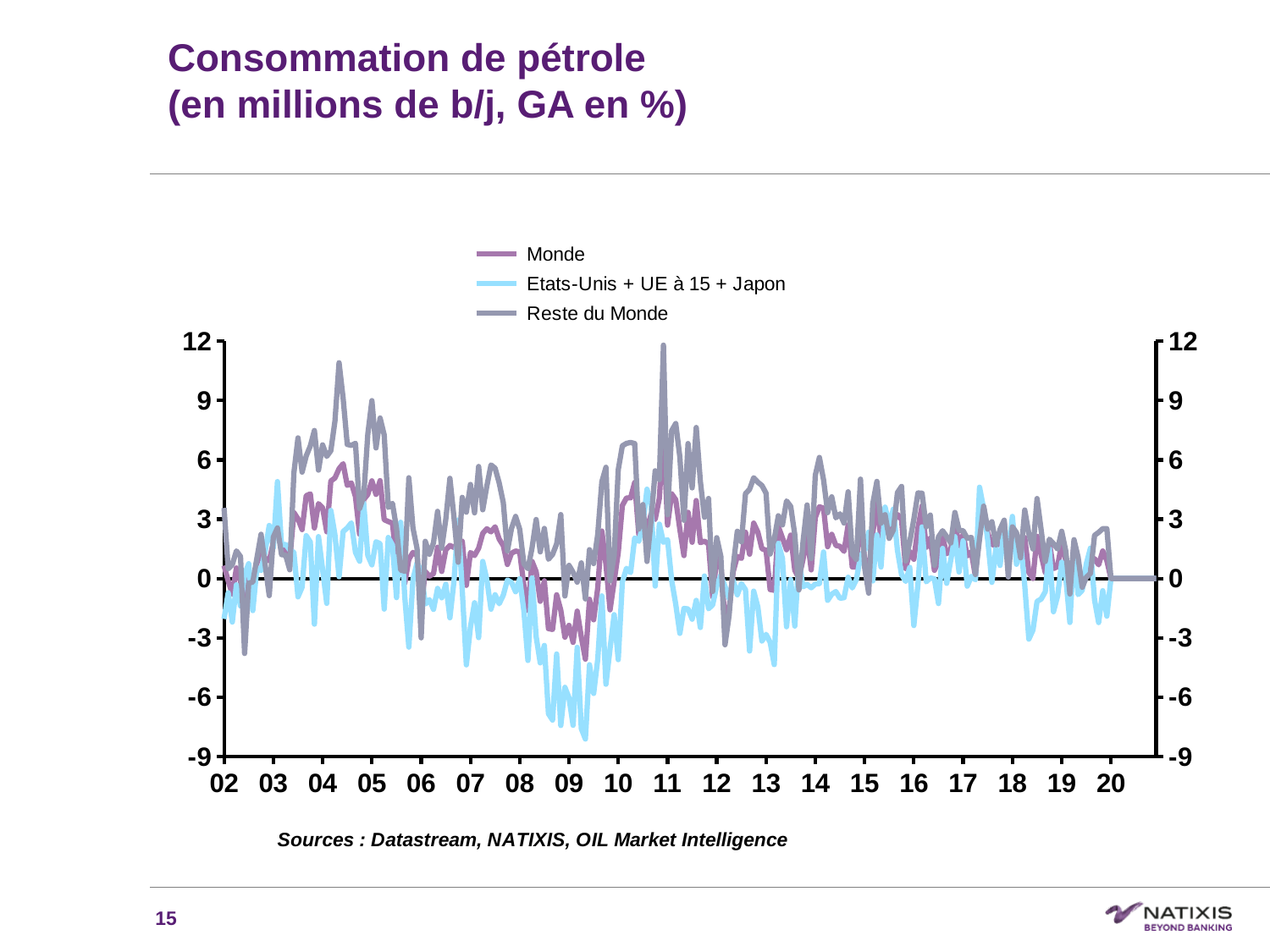
What kind of chart is shown on the slide? line chart Is the peak of the Monde series around 2004 greater or less than 3? greater Which series reaches the lowest value on the chart? Etats-Unis + UE à 15 + Japon What are the three series named in the legend? Monde, Etats-Unis + UE à 15 + Japon, Reste du Monde Is the peak of the Reste du Monde series around 2011 greater or less than 9? greater How many year labels are shown on the x axis? 19 How many series does the legend list? 3 Which series reaches the highest value on the chart? Reste du Monde Is the peak of the Reste du Monde series around 2004 greater or less than 9? greater What is the title of the chart? Consommation de pétrole (en millions de b/j, GA en %) Around 2009, which series is lower: Monde or Etats-Unis + UE à 15 + Japon? Etats-Unis + UE à 15 + Japon